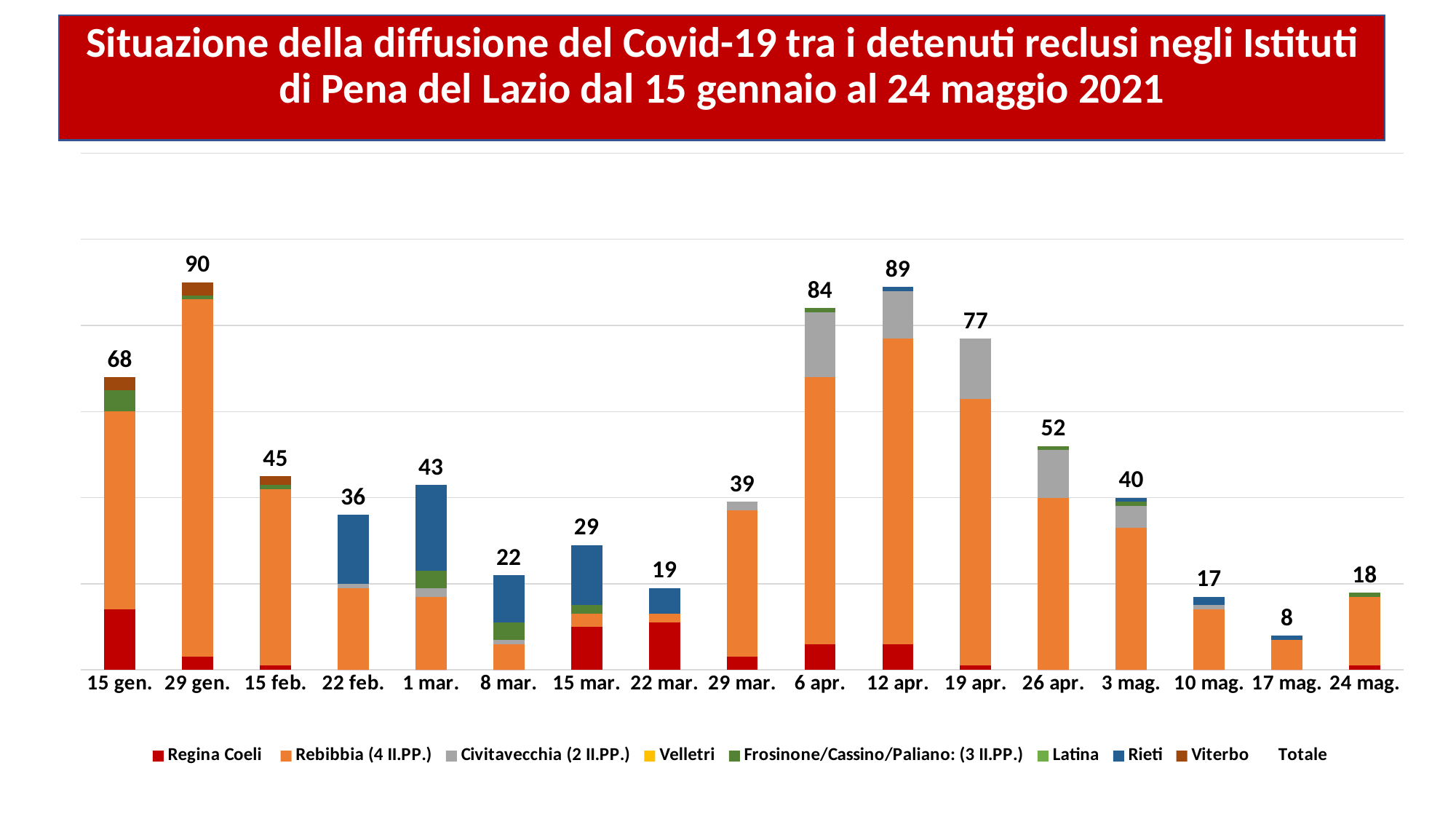
Which date has the lowest total? 17 mag. How many entries does the legend list? 9 What is the total value shown for the 6 apr. bar? 84 What is the difference between the totals for 29 gen. and 15 gen.? 22 How many dates are shown on the x axis? 17 What is the total value shown for the 29 gen. bar? 90 What is the difference between the totals for 12 apr. and 19 apr.? 12 What is the total value shown for the 17 mag. bar? 8 What kind of chart is shown on the slide? Stacked bar chart Do the totals rise or fall from 12 apr. to 17 mag.? Fall Which date has the highest total? 29 gen. Which has a larger total, 6 apr. or 12 apr.? 12 apr.